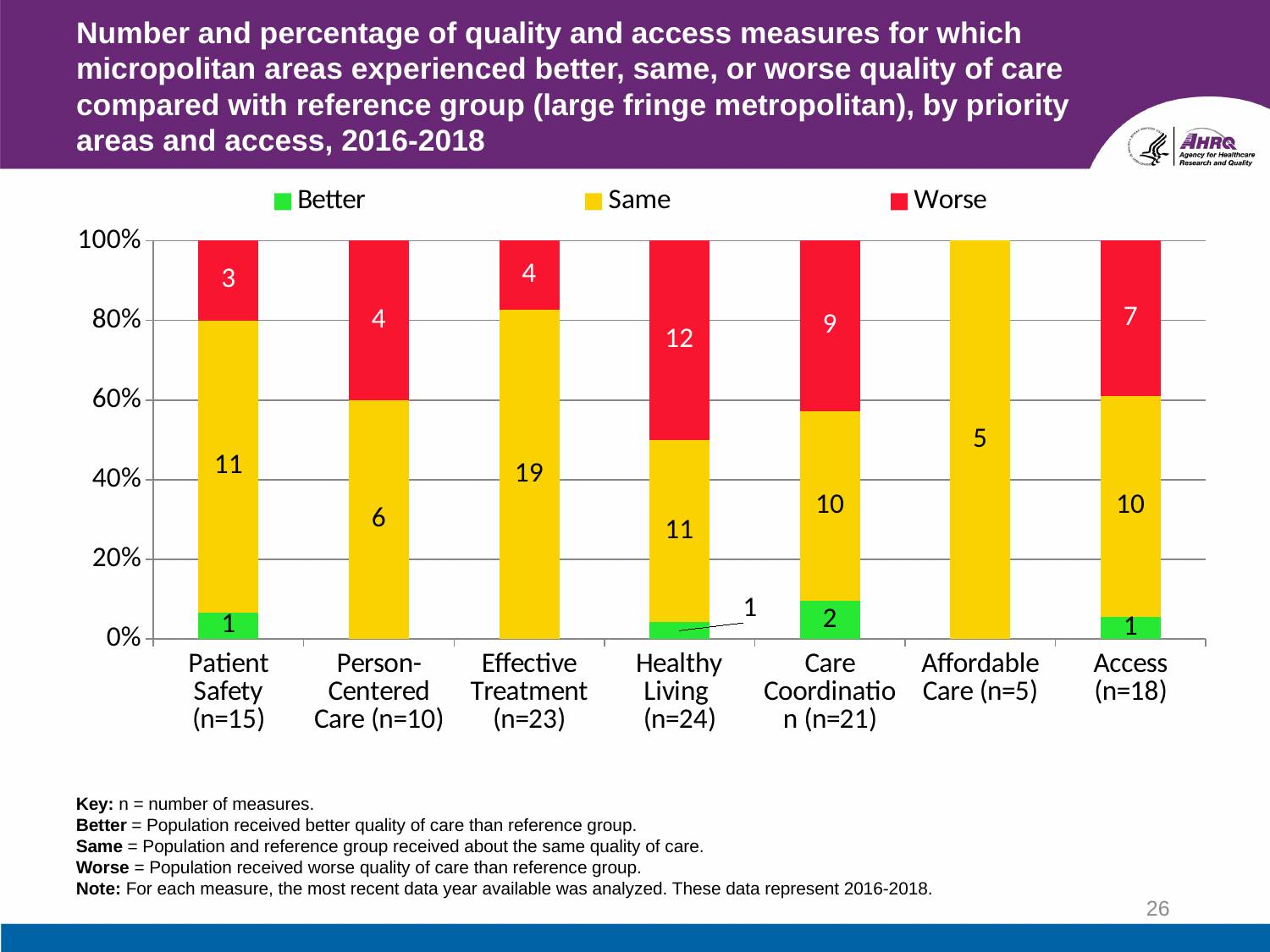
What is the difference between the number of "Worse" measures for Healthy Living (n=24) and for Patient Safety (n=15)? 9 Which priority area has the largest number of "Worse" measures? Healthy Living (n=24) What kind of chart is shown on the slide? Stacked bar chart Is the "Worse" share of the Healthy Living (n=24) bar greater or less than 40%? greater How many series does the legend list? 3 Which priority area has the largest number of "Same" measures? Effective Treatment (n=23) How many measures are labeled "Worse" for Healthy Living (n=24)? 12 How many measures are labeled "Same" for Effective Treatment (n=23)? 19 How many measures are labeled "Better" for Care Coordination (n=21)? 2 Which has more "Worse" measures: Care Coordination (n=21) or Access (n=18)? Care Coordination (n=21) How many priority area/access categories are shown on the x axis? 7 What is the total number of measures in the Patient Safety bar (Better + Same + Worse)? 15